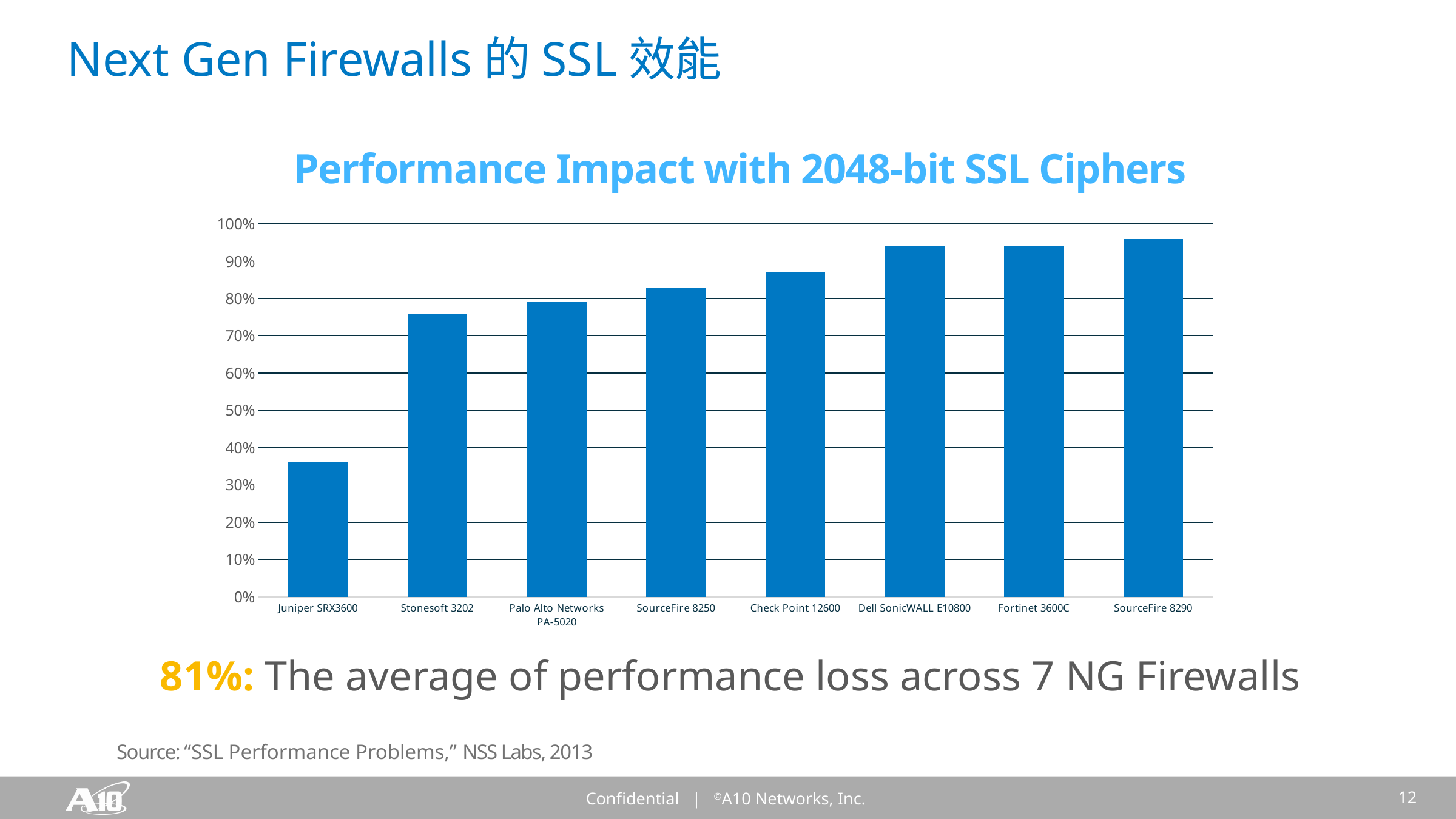
What is the title of the chart? Performance Impact with 2048-bit SSL Ciphers Which has a larger value, Juniper SRX3600 or Stonesoft 3202? Stonesoft 3202 Is the value for Check Point 12600 greater or less than 80%? greater Which firewall has the lowest performance impact on the chart? Juniper SRX3600 Do the bar values generally rise or fall from left to right across the chart? rise Is the value for SourceFire 8290 greater or less than 90%? greater Which has a larger value, SourceFire 8250 or Dell SonicWALL E10800? Dell SonicWALL E10800 Is the value for Stonesoft 3202 greater or less than 70%? greater How many firewall products are plotted on the chart? 8 What kind of chart is shown on the slide? bar chart